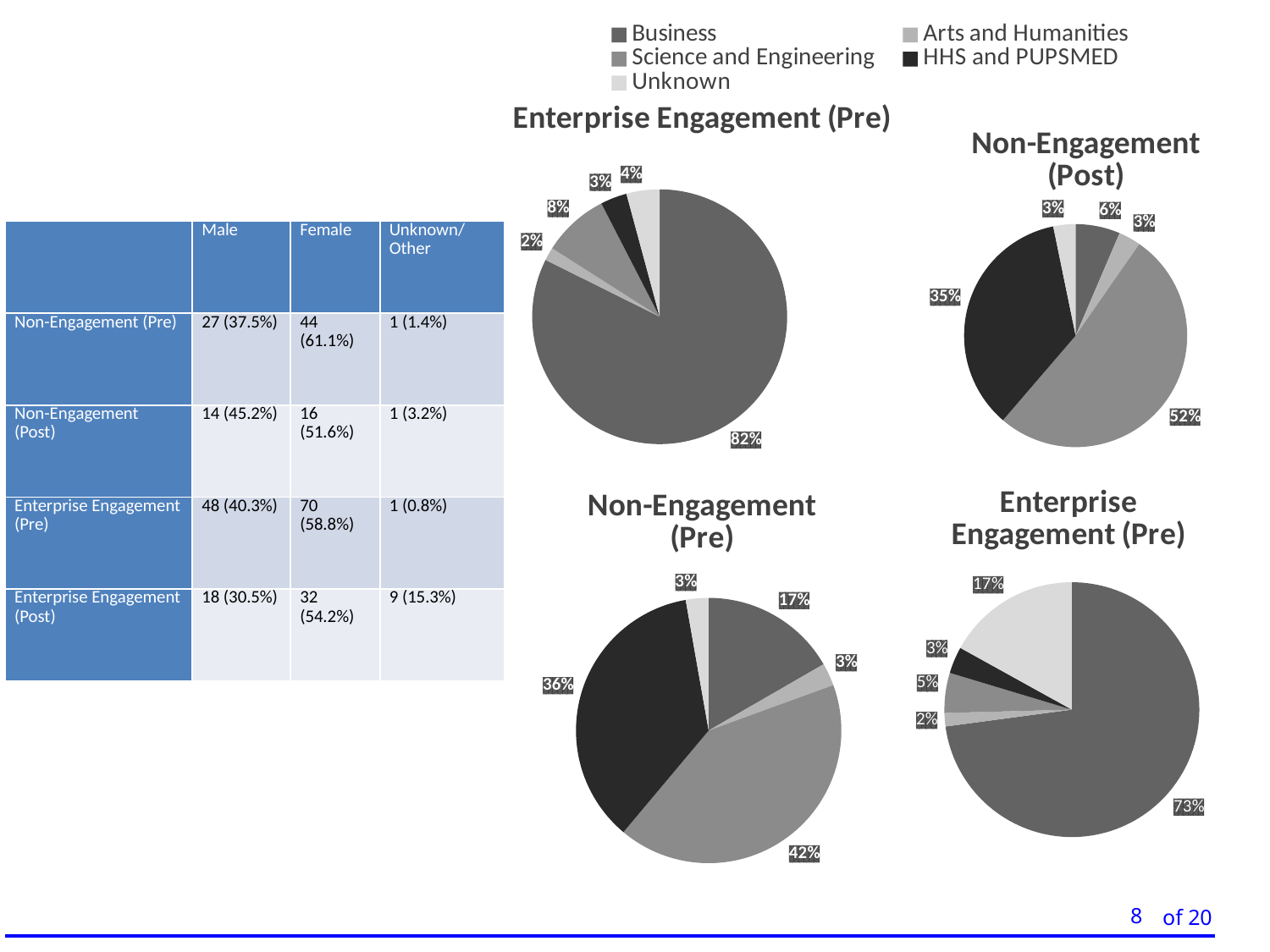
In the bottom-middle pie chart titled Non-Engagement (Pre), what share does the Business slice have? 17% In the top-right pie chart titled Non-Engagement (Post), what is the share of the largest slice? 52% In the bottom-right pie chart titled Enterprise Engagement (Pre), what share does the Unknown slice have? 17% In the bottom-right pie chart titled Enterprise Engagement (Pre), what is the difference between the Business slice and the Unknown slice? 56% In the bottom-right pie chart titled Enterprise Engagement (Pre), what share does the Business slice have? 73% How many categories does the shared legend for the pie charts list? 5 In the bottom-middle pie chart titled Non-Engagement (Pre), which is larger, the Science and Engineering slice or the HHS and PUPSMED slice? Science and Engineering What kind of chart is the top-left chart titled Enterprise Engagement (Pre)? Pie chart